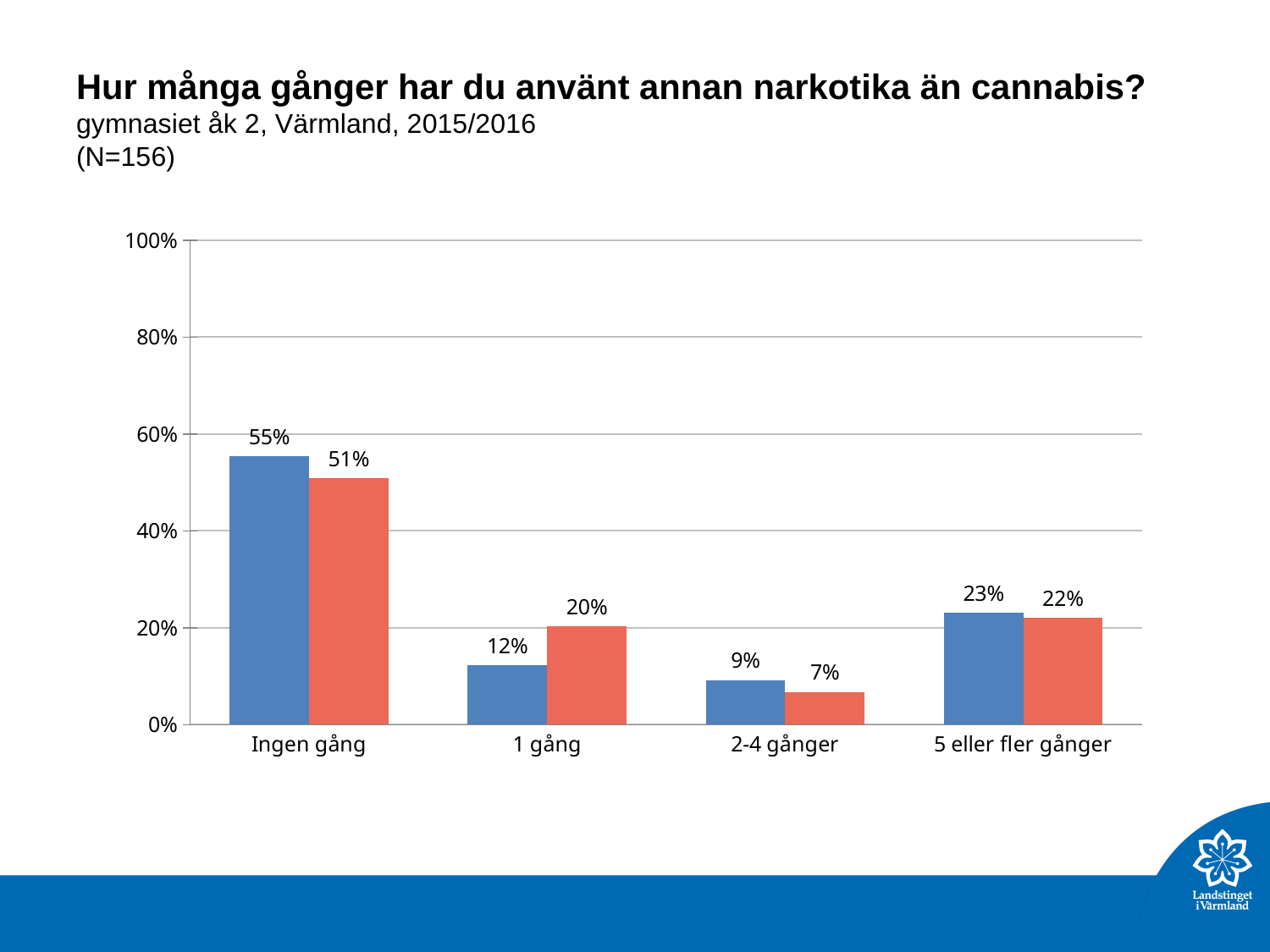
What is the value of the red bar for "5 eller fler gånger"? 22% How many categories are shown on the x axis? 4 For "2-4 gånger", which bar is larger, the blue or the red? blue What is the value of the blue bar for "Ingen gång"? 55% What is the difference between the blue and red bars for "Ingen gång"? 4% What is the value of the red bar for "1 gång"? 20% What is the N value stated in the chart title? 156 What is the difference between the red and blue bars for "1 gång"? 8% What kind of chart is shown on the slide? bar chart Which category has the highest blue bar? Ingen gång Which category has the lowest red bar? 2-4 gånger What is the value of the blue bar for "2-4 gånger"? 9%